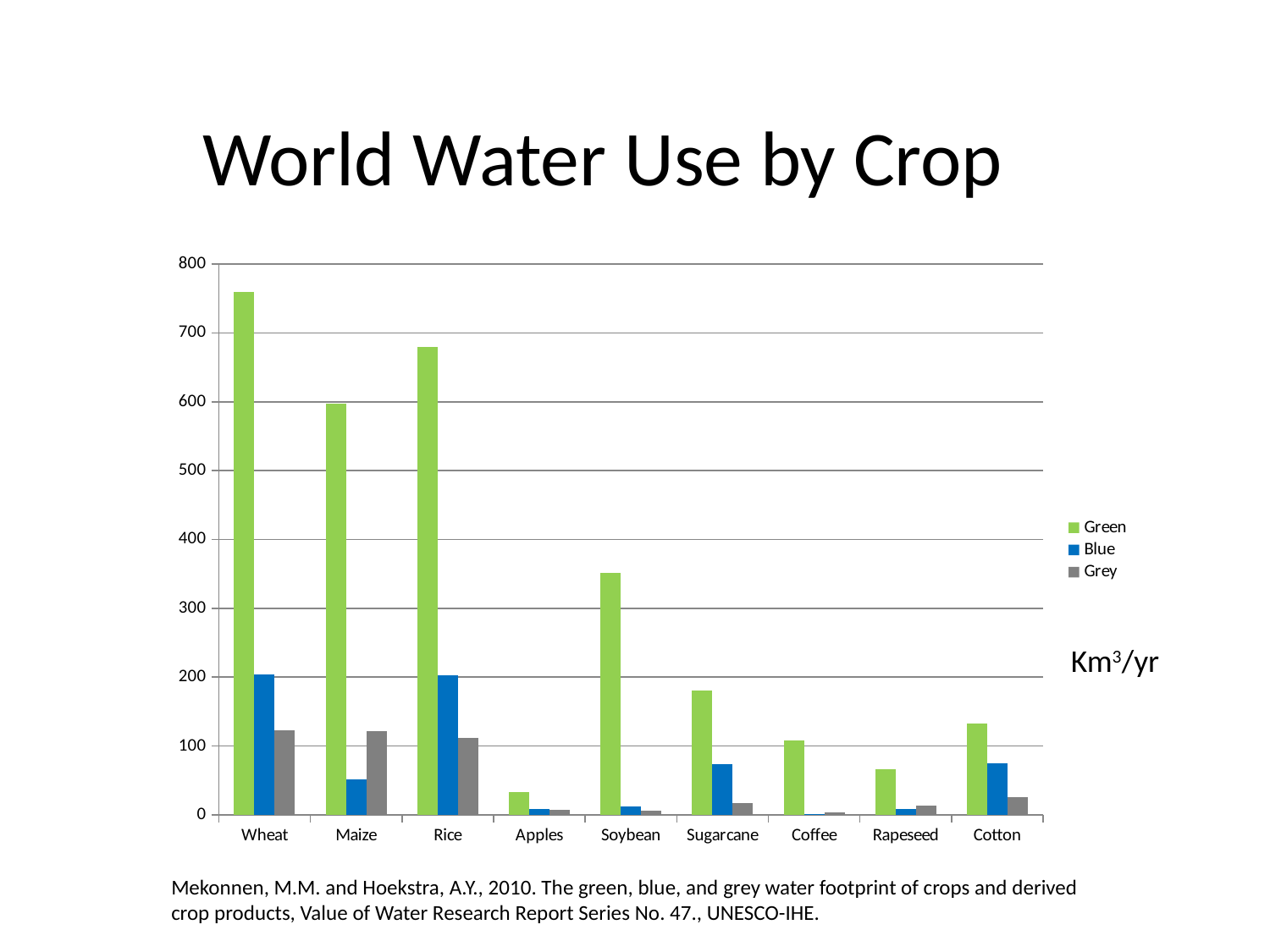
Which crop has the highest Green water use? Wheat What kind of chart is shown on the slide? bar chart Which crop has the lowest Green water use? Apples Is the Green value for Maize greater or less than 500? greater Which has the larger Green value, Wheat or Rice? Wheat Is the Green value for Sugarcane greater or less than 200? less How many crops are shown on the x axis of the chart? 9 What is the title of the chart? World Water Use by Crop What unit is shown next to the chart for the values? Km³/yr How many series does the legend list? 3 Is the Green value for Wheat greater or less than 700? greater